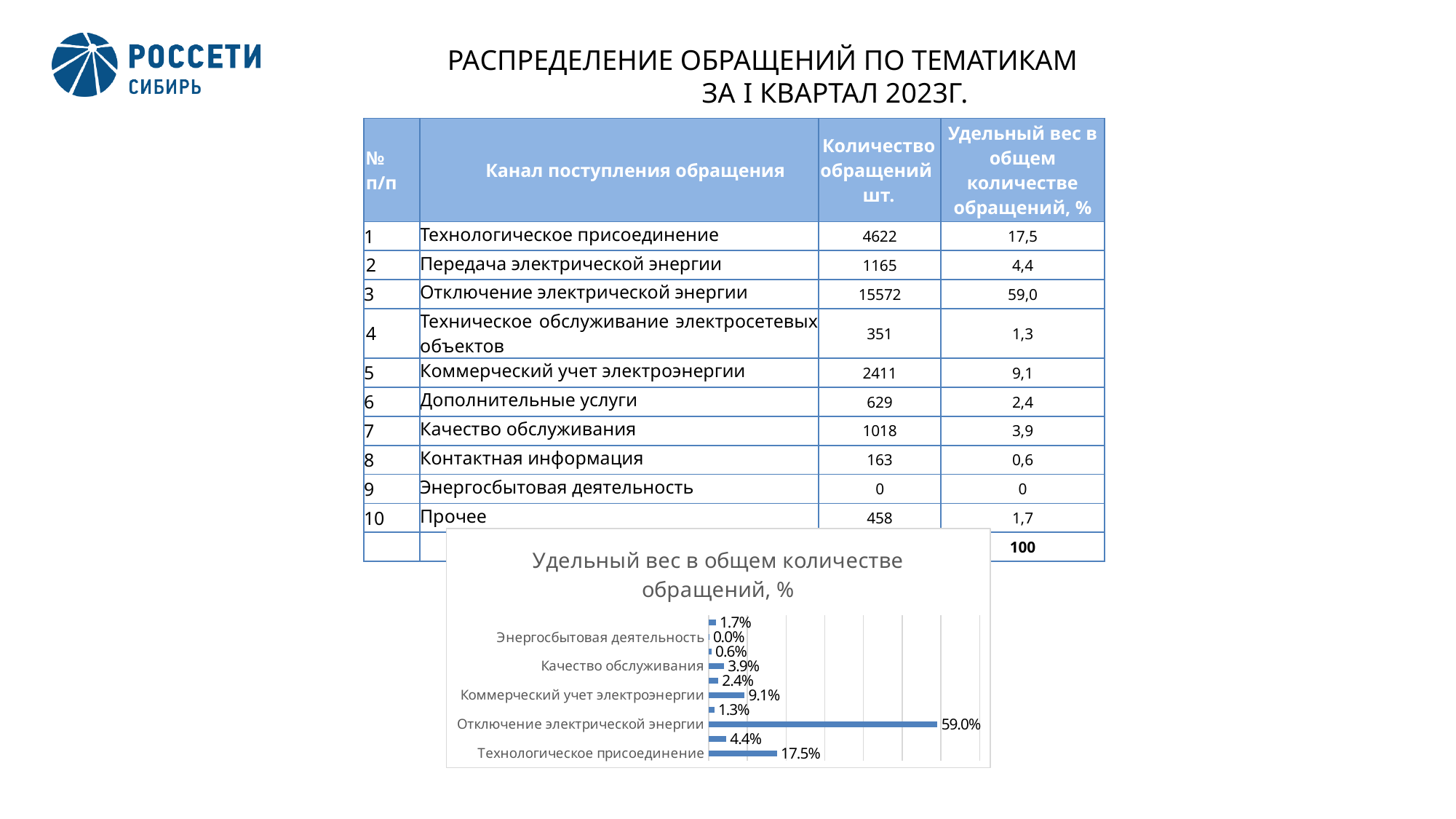
How many bars are plotted in the chart? 10 In the chart, what is the value for Технологическое присоединение? 17.5% Which category has the highest value in the chart? Отключение электрической энергии In the chart, what is the value for Отключение электрической энергии? 59.0% In the chart, what is the difference between the values for Отключение электрической энергии and Технологическое присоединение? 41.5% In the chart, which is larger: the value for Коммерческий учет электроэнергии or the value for Качество обслуживания? Коммерческий учет электроэнергии What kind of chart is shown on the slide? bar chart In the chart, what is the value for Коммерческий учет электроэнергии? 9.1% Which category has the lowest value in the chart? Энергосбытовая деятельность In the chart, what is the value for Качество обслуживания? 3.9% In the chart, what is the value for Энергосбытовая деятельность? 0.0% What is the title of the chart on the slide? Удельный вес в общем количестве обращений, %